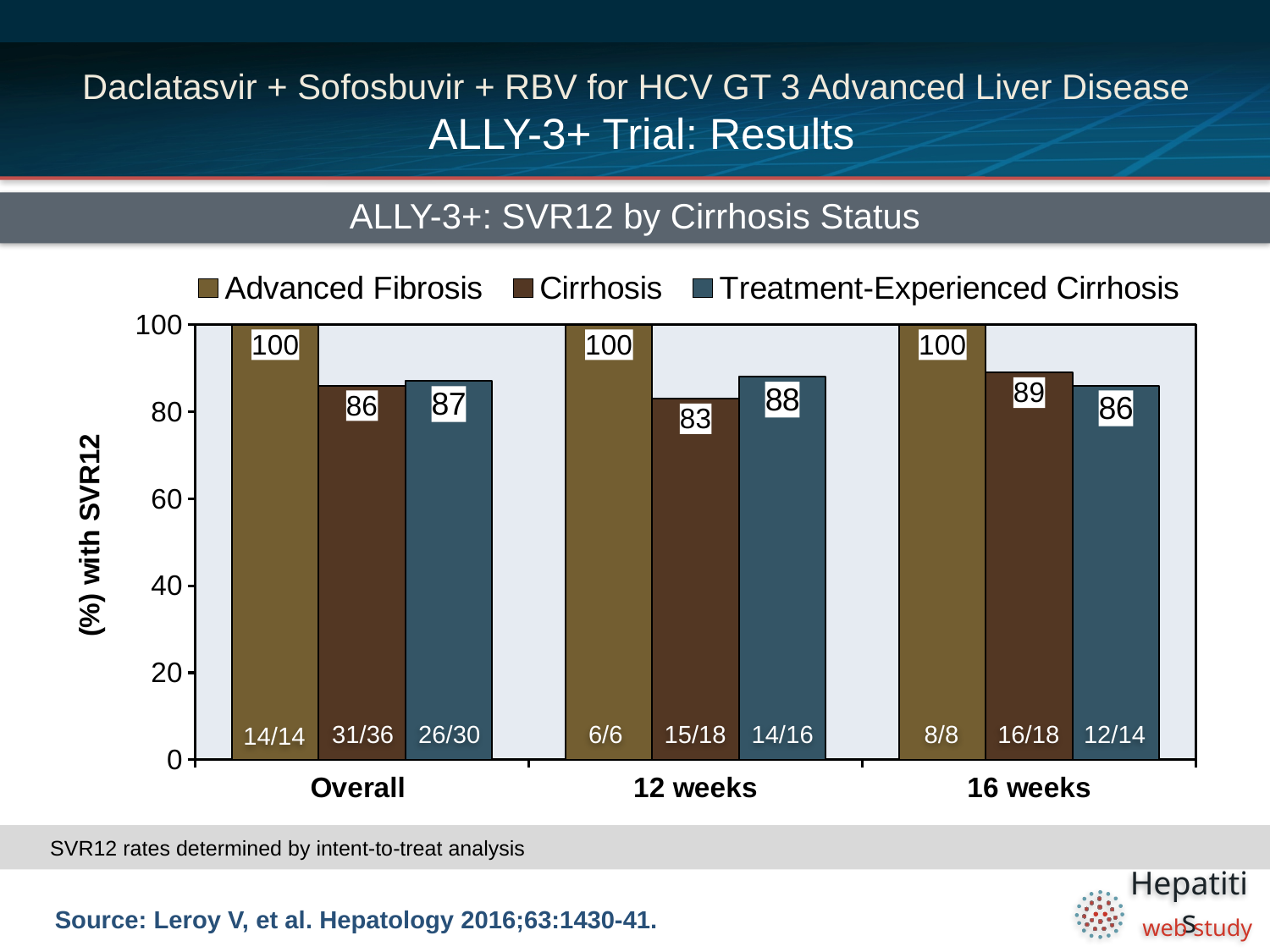
What is the title of the chart? ALLY-3+: SVR12 by Cirrhosis Status What is the difference between the Advanced Fibrosis and Cirrhosis SVR12 rates at 12 weeks? 17 At 16 weeks, which is larger: the SVR12 rate for Cirrhosis or for Treatment-Experienced Cirrhosis? Cirrhosis Which series has the lowest SVR12 rate at 12 weeks? Cirrhosis What fraction of patients is shown for Advanced Fibrosis in the Overall group? 14/14 What is the SVR12 rate for Cirrhosis in the Overall group? 86 How many groups are shown on the x axis? 3 Which series has the highest SVR12 rate at 16 weeks? Advanced Fibrosis How many series does the legend list? 3 What is the SVR12 rate for Cirrhosis at 16 weeks? 89 What kind of chart is shown on the slide? Bar chart What is the SVR12 rate for Treatment-Experienced Cirrhosis at 12 weeks? 88